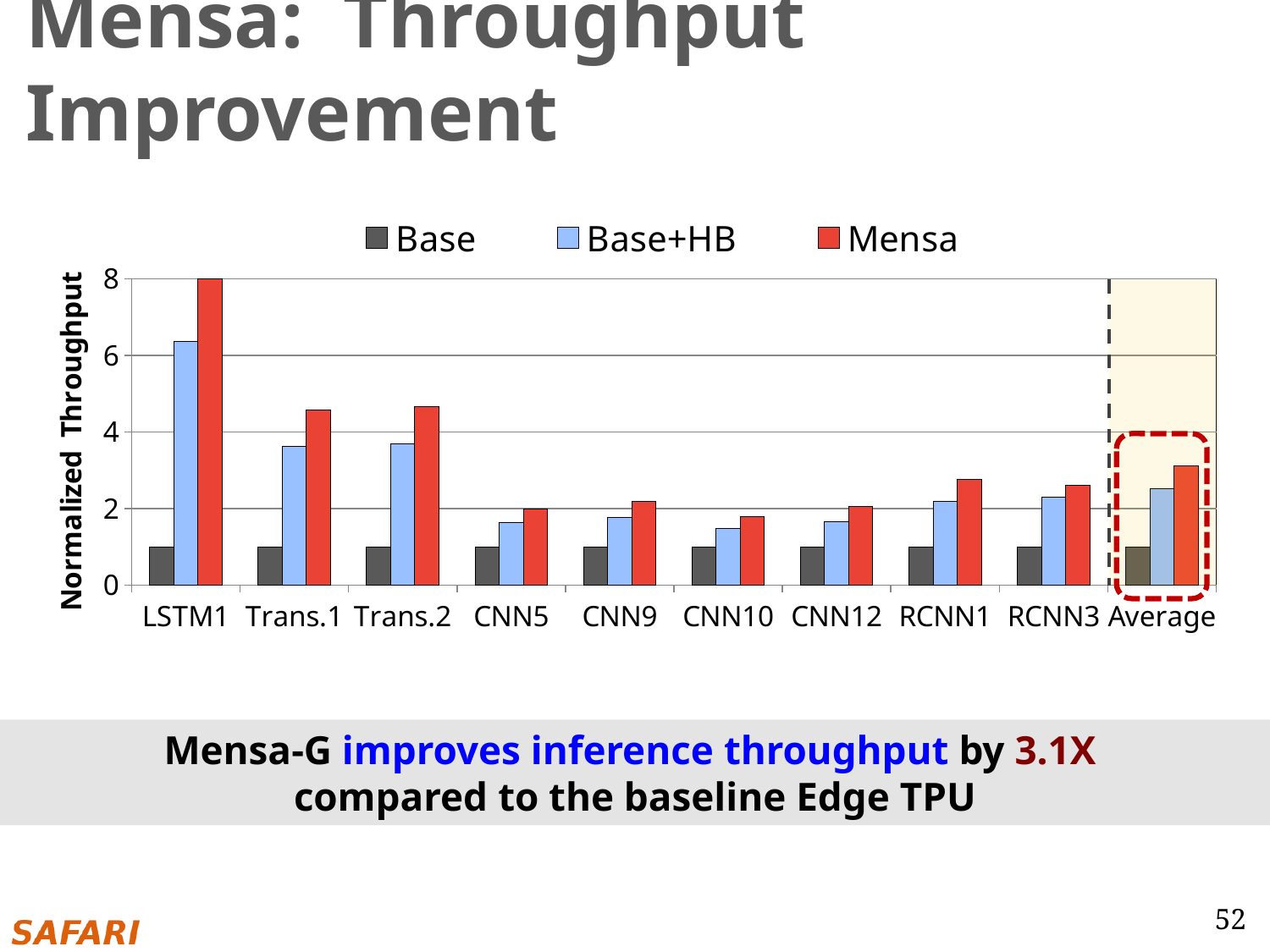
Is the Base+HB value for Trans.2 greater or less than 4? less Which is larger for CNN12, the Base+HB value or the Mensa value? Mensa How many series does the legend list? 3 What is the label of the y axis? Normalized Throughput Is the Mensa value for Trans.1 greater or less than 4? greater Which category has the highest Base+HB value? LSTM1 What kind of chart is shown on the slide? bar chart Which is larger, the Mensa value for Trans.2 or the Mensa value for RCNN1? Trans.2 Is the Mensa value for CNN10 greater or less than 2? less Which category has the highest Mensa value? LSTM1 How many categories are shown on the x axis? 10